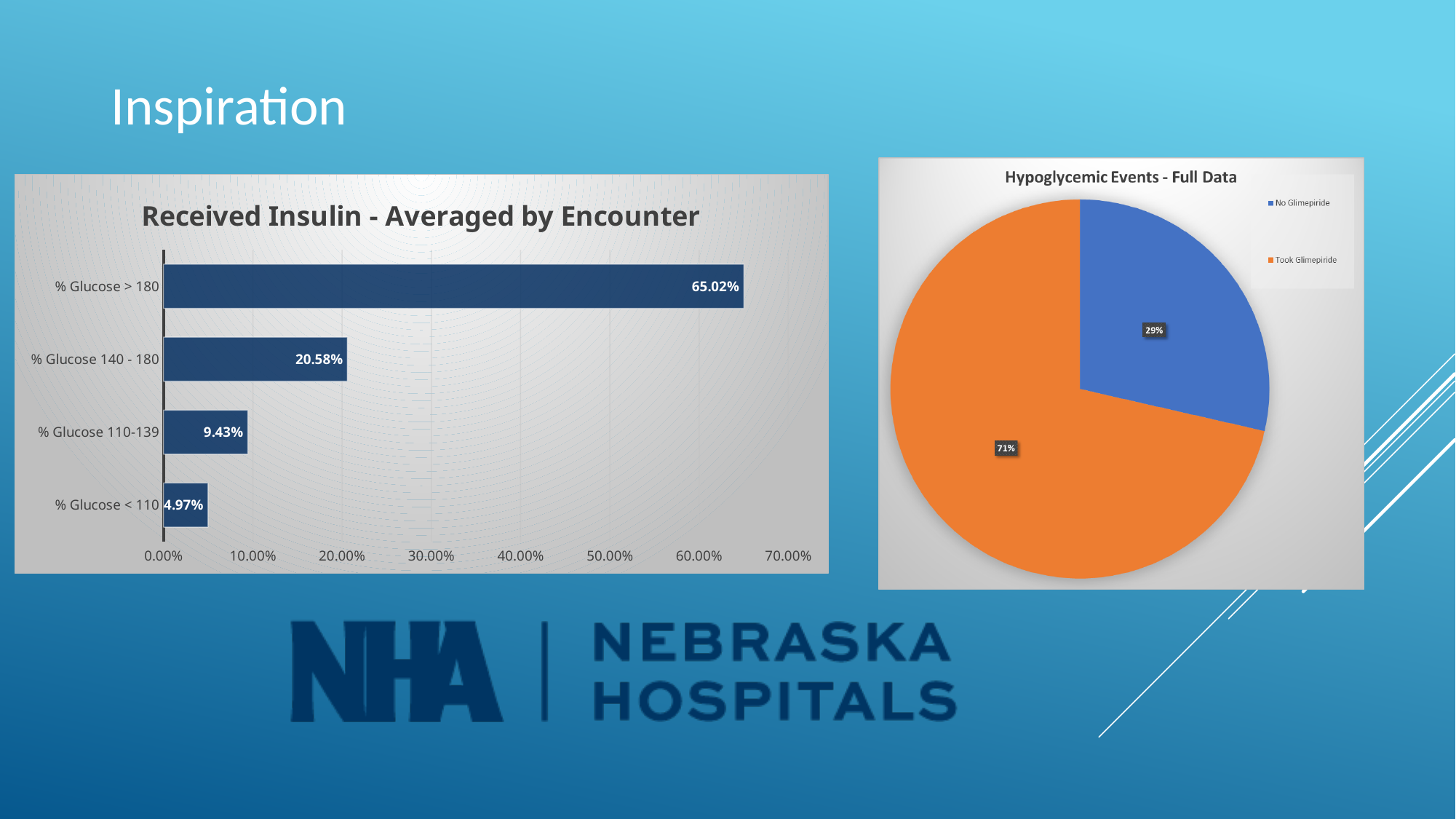
In the 'Received Insulin - Averaged by Encounter' chart, what is the value for % Glucose > 180? 65.02% In the 'Received Insulin - Averaged by Encounter' chart, which category has the lowest value? % Glucose < 110 In the 'Hypoglycemic Events - Full Data' chart, what share of the pie is 'Took Glimepiride'? 71% What kind of chart is 'Received Insulin - Averaged by Encounter'? Bar chart What kind of chart is 'Hypoglycemic Events - Full Data'? Pie chart In the 'Received Insulin - Averaged by Encounter' chart, how many categories are shown? 4 In the 'Received Insulin - Averaged by Encounter' chart, what is the difference between the values for % Glucose > 180 and % Glucose 140 - 180? 44.44% In the 'Hypoglycemic Events - Full Data' chart, what colour is the 'Took Glimepiride' slice? Orange In the 'Received Insulin - Averaged by Encounter' chart, what is the value for % Glucose 110-139? 9.43% In the 'Hypoglycemic Events - Full Data' chart, what share of the pie is 'No Glimepiride'? 29% In the 'Received Insulin - Averaged by Encounter' chart, which category has the highest value? % Glucose > 180 In the 'Received Insulin - Averaged by Encounter' chart, which is larger: % Glucose 140 - 180 or % Glucose 110-139? % Glucose 140 - 180